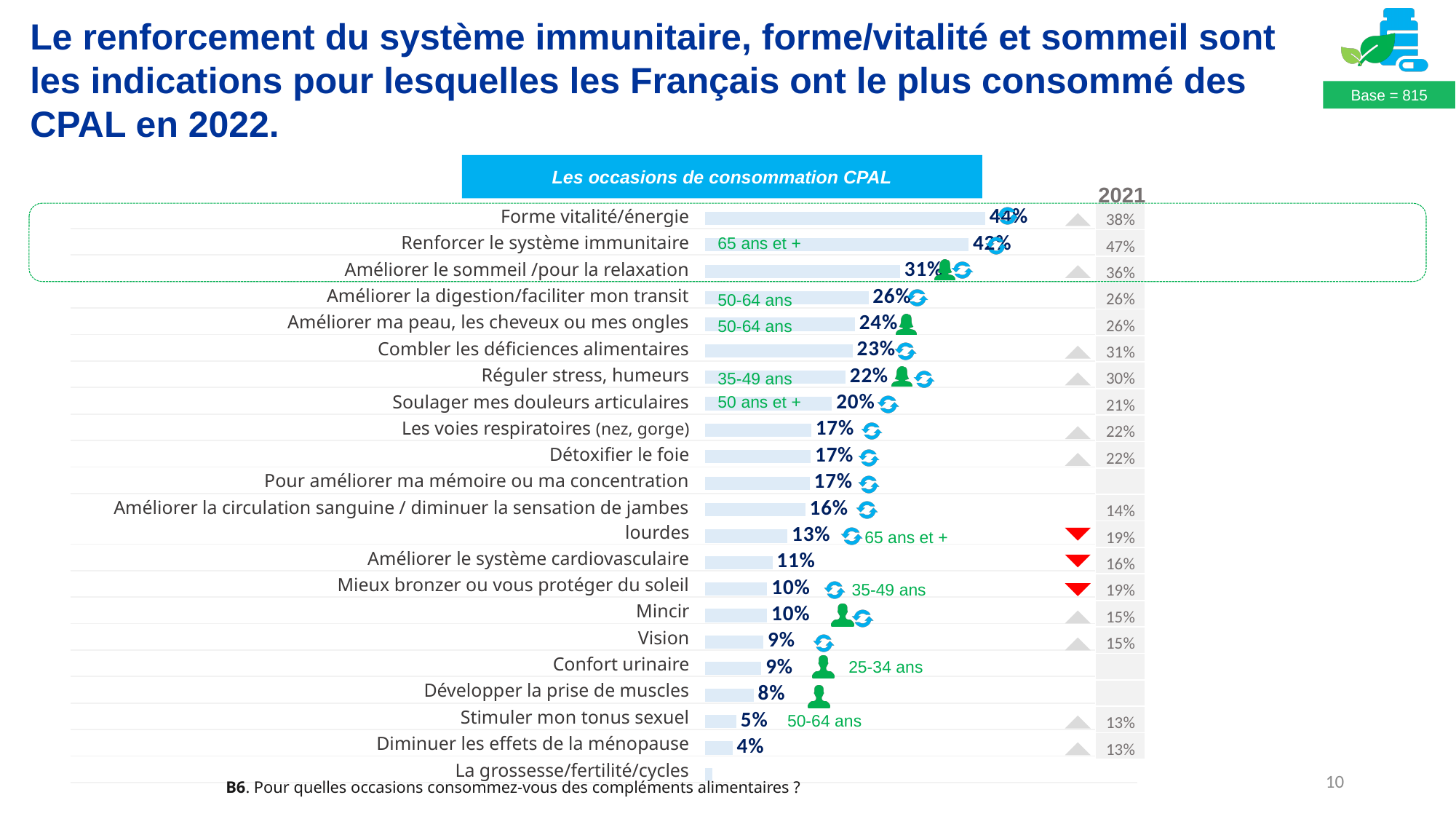
For "Renforcer le système immunitaire", which is larger: the 2022 value or the 2021 value? 2021 What was the 2021 value for "Renforcer le système immunitaire"? 47% What is the 2022 value for "Mincir"? 10% What is the title shown above the chart? Les occasions de consommation CPAL Which category has the highest 2022 value? Forme vitalité/énergie What kind of chart is shown on the slide? Bar chart What is the 2022 value for "Stimuler mon tonus sexuel"? 5% Which has the larger 2022 value: "Combler les déficiences alimentaires" or "Réguler stress, humeurs"? Combler les déficiences alimentaires What is the 2022 value for "Renforcer le système immunitaire"? 42% What is the 2022 value for "Diminuer les effets de la ménopause"? 4% What is the 2022 value for "Forme vitalité/énergie"? 44% What is the difference between the 2022 values for "Améliorer le sommeil /pour la relaxation" and "Améliorer la digestion/faciliter mon transit"? 5 percentage points